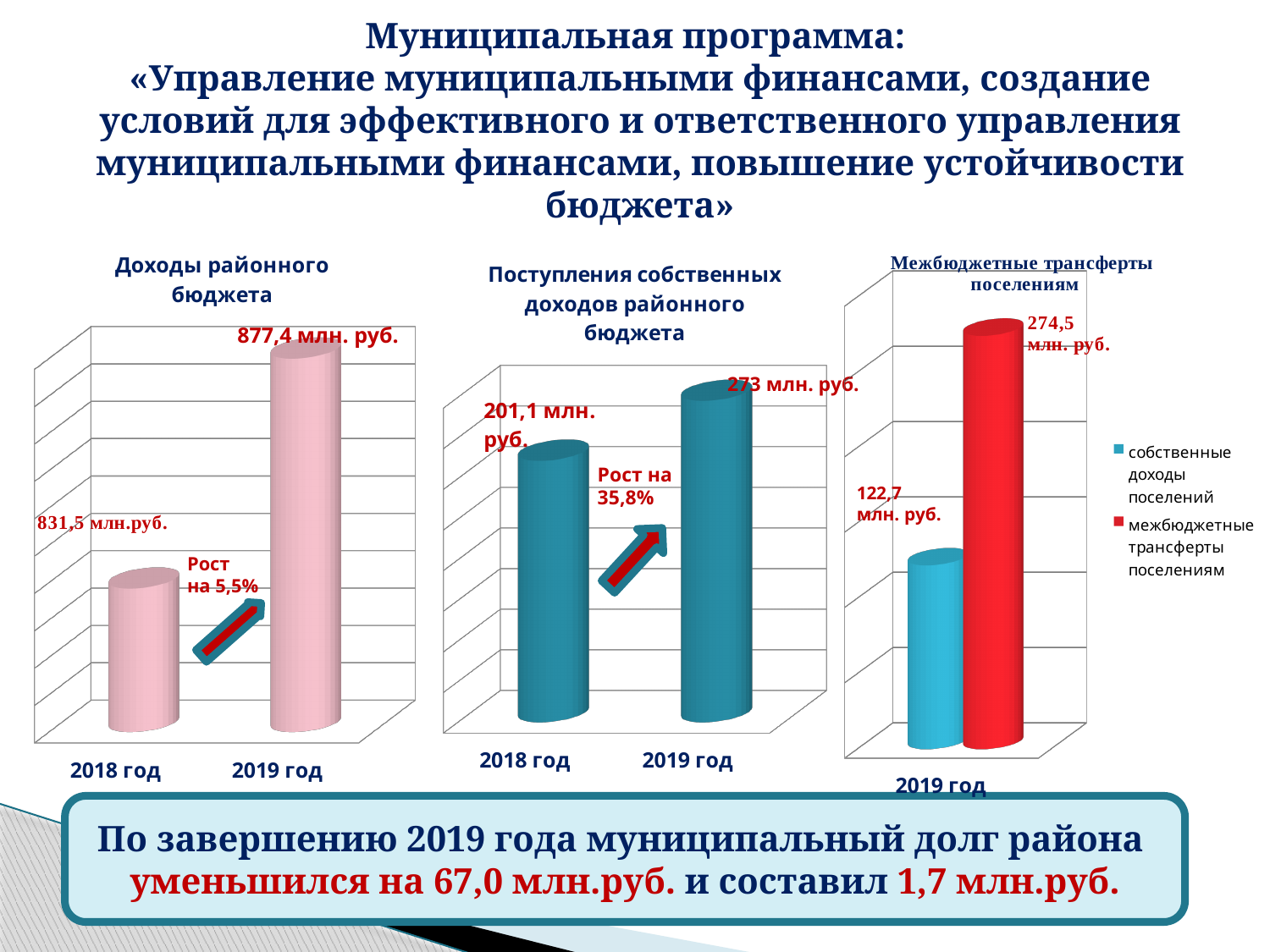
In the chart 'Поступления собственных доходов районного бюджета', what is the value for 2019 год? 273 млн. руб. In the chart 'Доходы районного бюджета', by how much did the value increase from 2018 год to 2019 год? 45,9 млн. руб. In the chart 'Доходы районного бюджета', what is the value for 2019 год? 877,4 млн. руб. In the chart 'Межбюджетные трансферты поселениям', which is larger: собственные доходы поселений or межбюджетные трансферты поселениям? межбюджетные трансферты поселениям In the chart 'Межбюджетные трансферты поселениям', what is the value for собственные доходы поселений? 122,7 млн. руб. In the chart 'Поступления собственных доходов районного бюджета', what is the difference between the 2019 год and 2018 год values? 71,9 млн. руб. In the chart 'Поступления собственных доходов районного бюджета', what is the value for 2018 год? 201,1 млн. руб. In the chart 'Поступления собственных доходов районного бюджета', what percentage growth is indicated on the chart? 35,8% In the chart 'Межбюджетные трансферты поселениям', what is the value for межбюджетные трансферты поселениям? 274,5 млн. руб. In the chart 'Доходы районного бюджета', what is the value for 2018 год? 831,5 млн.руб. In the chart 'Доходы районного бюджета', do the values rise or fall from 2018 год to 2019 год? rise In the chart 'Межбюджетные трансферты поселениям', how many series does the legend list? 2